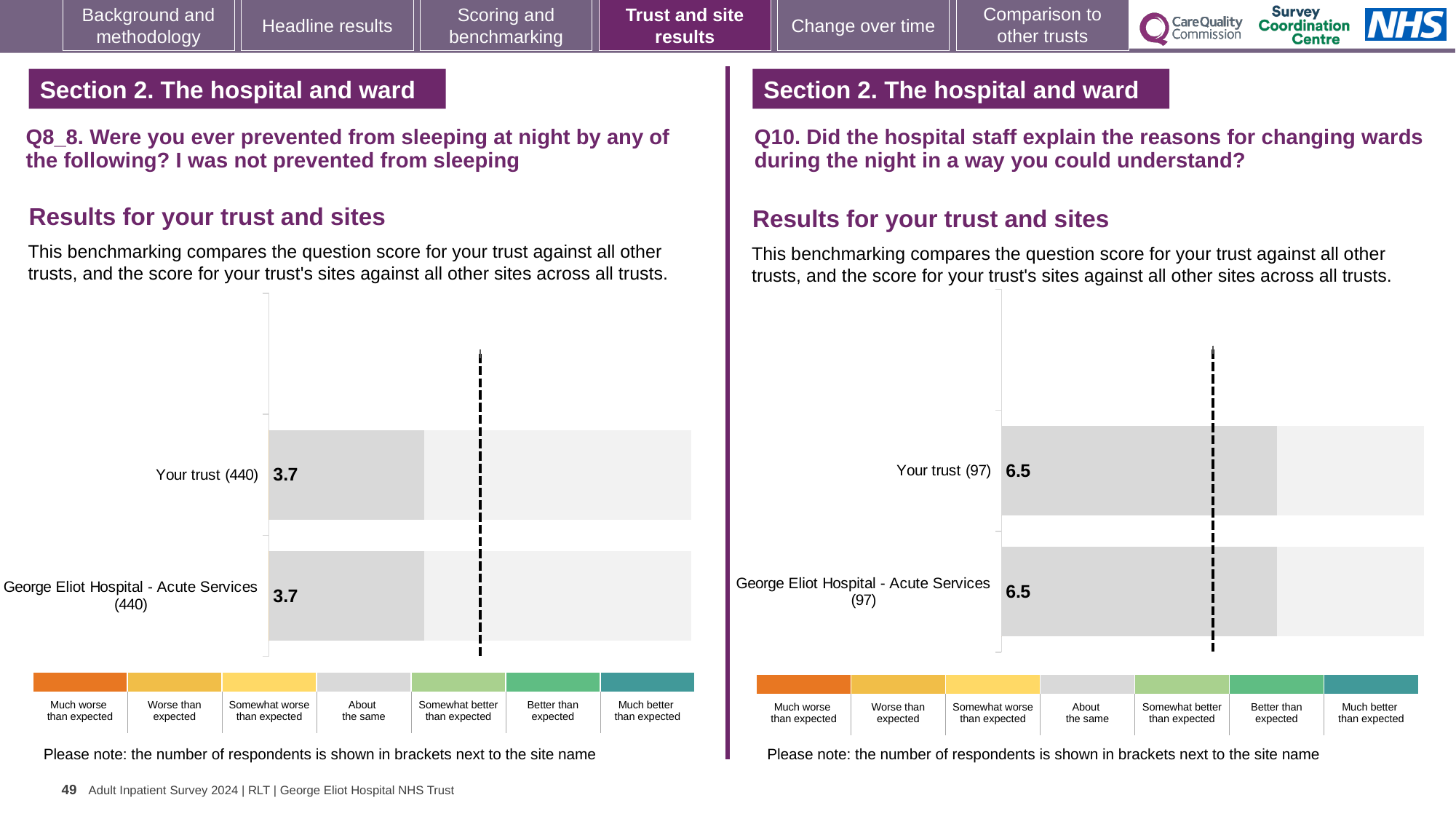
In the left chart (Q8_8), what is the score for Your trust? 3.7 In the left chart (Q8_8), how many respondents are shown in brackets for Your trust? 440 How many categories (bars) are plotted in the right chart (Q10)? 2 In the right chart (Q10), what is the score for George Eliot Hospital - Acute Services? 6.5 In the right chart (Q10), how many respondents are shown in brackets for George Eliot Hospital - Acute Services? 97 How many categories (bars) are plotted in the left chart (Q8_8)? 2 In the right chart (Q10), what is the score for Your trust? 6.5 How many benchmark bands are shown in the colour key below the left chart (Q8_8)? 7 In the left chart (Q8_8), what is the score for George Eliot Hospital - Acute Services? 3.7 What kind of chart is used in the right chart (Q10)? Bar chart In the left chart (Q8_8), what is the difference between the score for Your trust and the score for George Eliot Hospital - Acute Services? 0 In the right chart (Q10), what is the difference between the score for Your trust and the score for George Eliot Hospital - Acute Services? 0